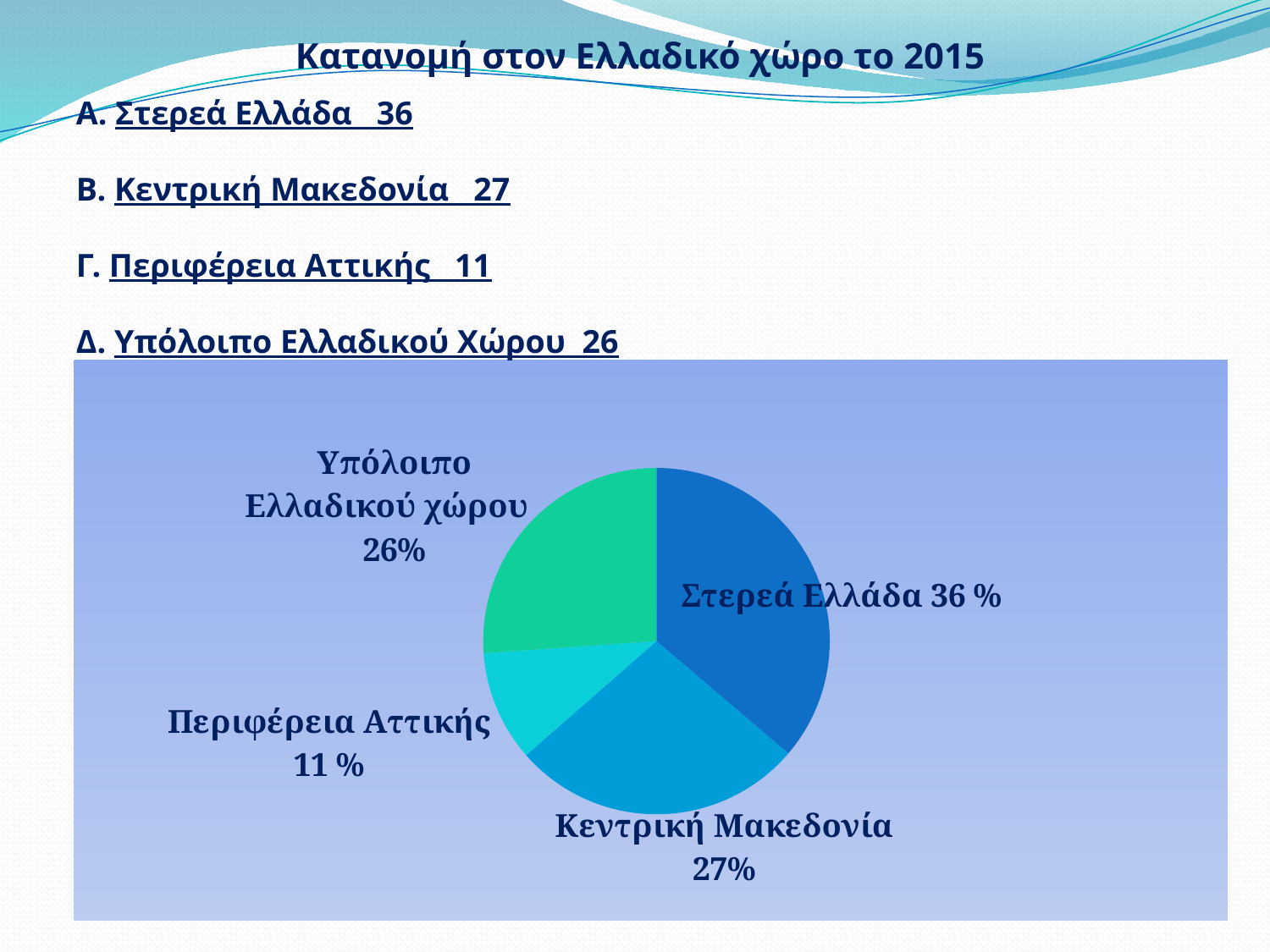
Which slice of the pie chart is the smallest? Περιφέρεια Αττικής What share of the pie does Κεντρική Μακεδονία hold? 27% What is the difference in percentage points between Στερεά Ελλάδα and Περιφέρεια Αττικής? 25 What type of chart is shown on the slide? pie chart What share of the pie does Υπόλοιπο Ελλαδικού χώρου hold? 26% Which slice of the pie chart is the largest? Στερεά Ελλάδα What share of the pie does Στερεά Ελλάδα hold? 36 % How many slices does the pie chart have? 4 What is the title shown above the chart on the slide? Κατανομή στον Ελλαδικό χώρο το 2015 What is the difference in percentage points between Κεντρική Μακεδονία and Υπόλοιπο Ελλαδικού χώρου? 1 Which is larger, the slice for Στερεά Ελλάδα or the slice for Κεντρική Μακεδονία? Στερεά Ελλάδα